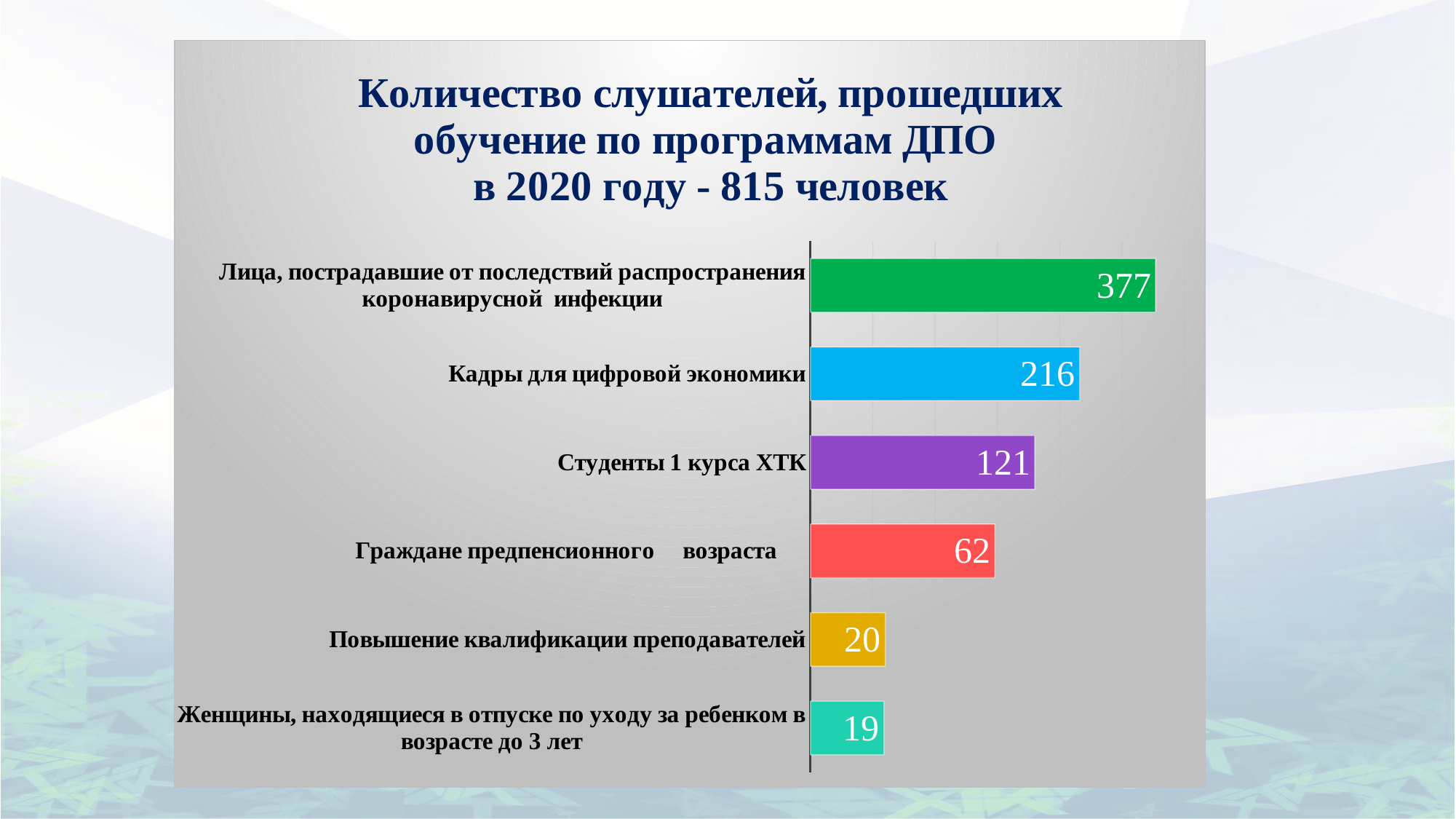
What kind of chart is shown on the slide? Bar chart What total number of people is stated in the chart title? 815 человек What is the difference between the values for Лица, пострадавшие от последствий распространения коронавирусной инфекции and Кадры для цифровой экономики? 161 What is the value for Повышение квалификации преподавателей? 20 How many categories are shown in the chart? 6 What is the difference between the values for Студенты 1 курса ХТК and Граждане предпенсионного возраста? 59 What is the value for Кадры для цифровой экономики? 216 Which category has the lowest value? Женщины, находящиеся в отпуске по уходу за ребенком в возрасте до 3 лет Which category has the highest value? Лица, пострадавшие от последствий распространения коронавирусной инфекции What is the value for Граждане предпенсионного возраста? 62 Which is larger: the value for Кадры для цифровой экономики or the value for Студенты 1 курса ХТК? Кадры для цифровой экономики What is the value for Студенты 1 курса ХТК? 121